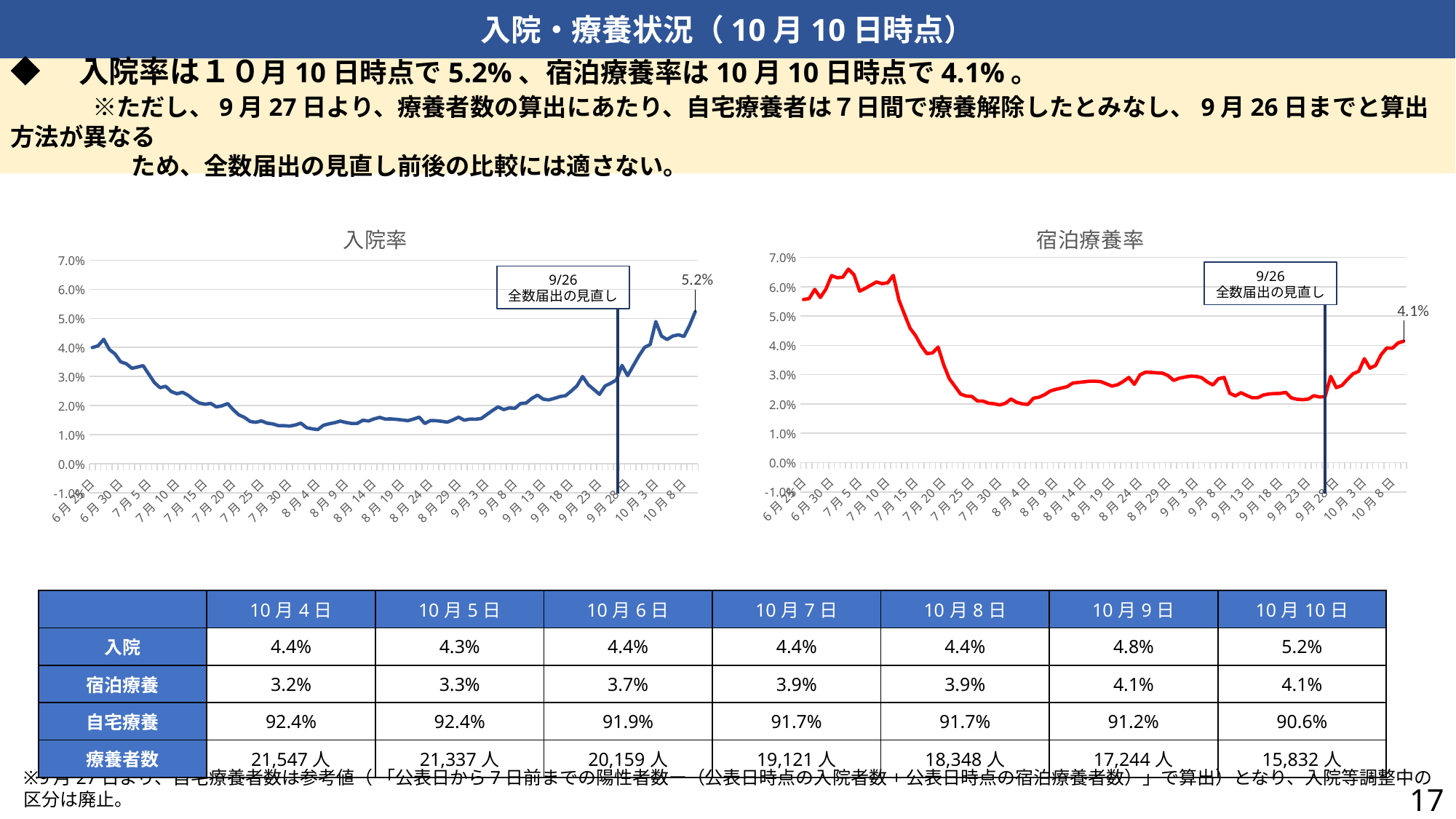
In the 宿泊療養率 chart, does the line rise or fall between 7月10日 and 7月25日? fall In the 入院率 chart, is the value around 8月4日 greater or less than 2.0%? less What does the annotation box at the vertical line in the 入院率 chart say? 9/26 全数届出の見直し In the 入院率 chart, what value is labeled at the final data point? 5.2% What colour is the line in the 宿泊療養率 chart? red In the 入院率 chart, is the value at 6月25日 greater or less than 3.0%? greater In the 入院率 chart, does the line rise or fall between 9月23日 and 10月8日? rise In the 宿泊療養率 chart, what value is labeled at the final data point? 4.1% What is the difference between the final labeled value of the 入院率 chart (5.2%) and that of the 宿泊療養率 chart (4.1%)? 1.1% What kind of chart is the 入院率 chart on the left? line chart Comparing the final labeled values of the two charts, which is larger: 入院率 or 宿泊療養率? 入院率